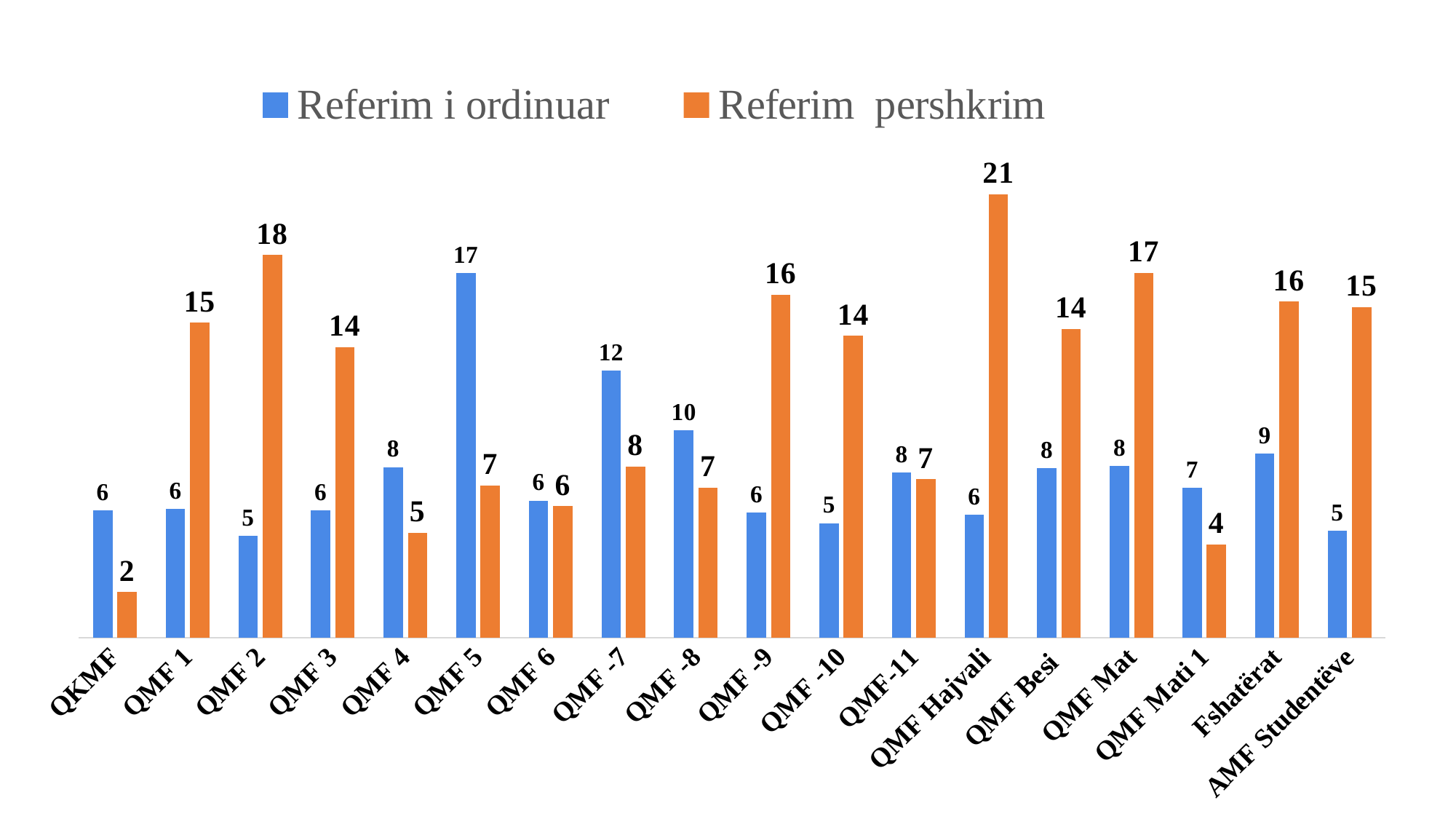
Which category has the highest Referim i ordinuar value? QMF 5 What is the Referim i ordinuar value for QMF 5? 17 How many categories are shown on the x axis? 18 What is the Referim pershkrim value for QMF Hajvali? 21 How many series does the legend list? 2 Which category has the lowest Referim pershkrim value? QKMF What kind of chart is shown on the slide? Bar chart For QMF Mati 1, which is larger: Referim i ordinuar or Referim pershkrim? Referim i ordinuar Which colour represents the Referim pershkrim series? Orange What is the difference between the Referim pershkrim and Referim i ordinuar values for QMF 2? 13 What is the Referim pershkrim value for QKMF? 2 Which category has the highest Referim pershkrim value? QMF Hajvali